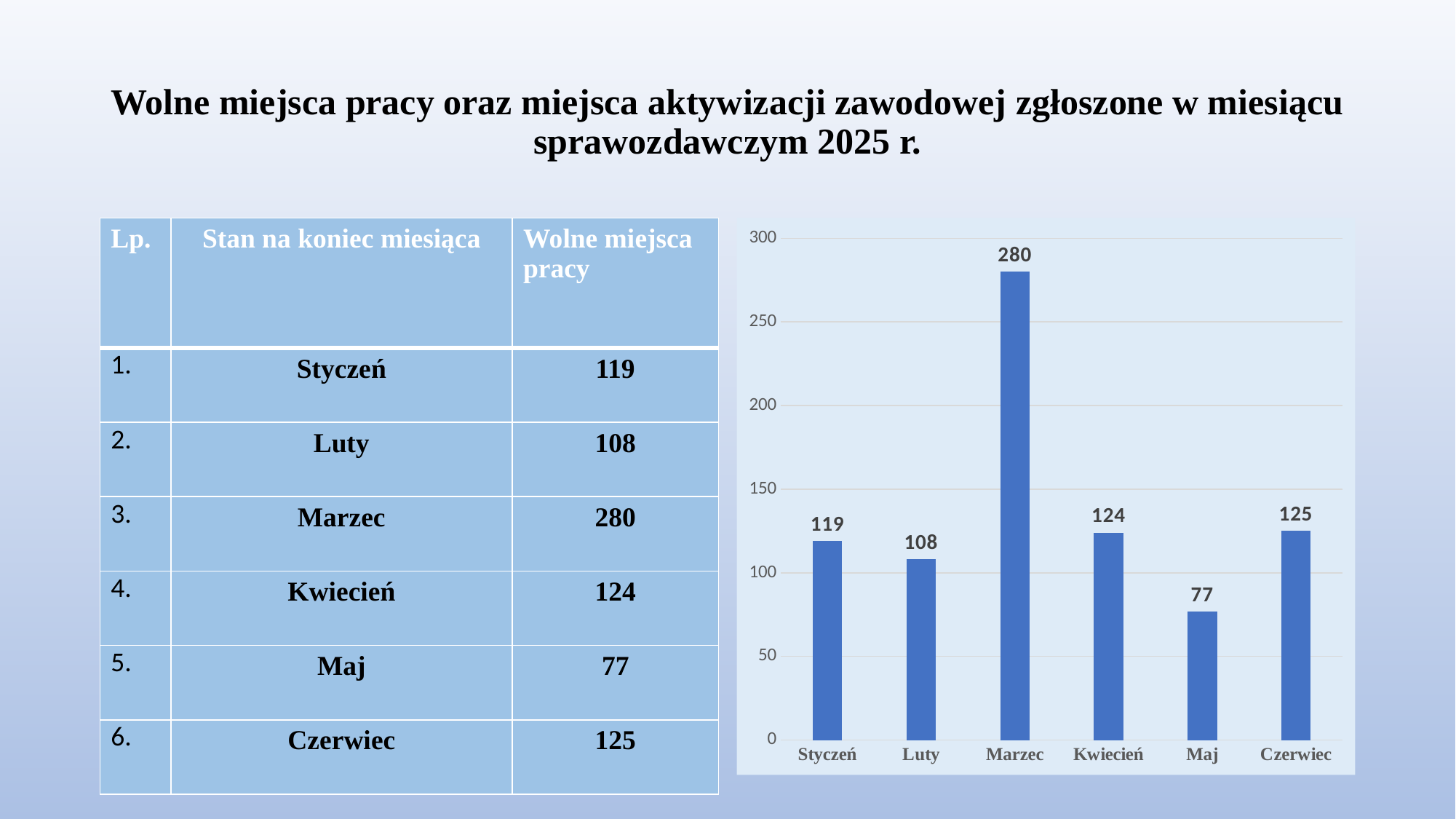
Which month has the lowest value in the bar chart? Maj What is the value for Czerwiec in the bar chart? 125 Is the value for Kwiecień in the bar chart greater or less than 100? greater Which is larger in the bar chart, the value for Styczeń or the value for Luty? Styczeń What is the difference between the values for Czerwiec and Maj in the bar chart? 48 Does the value rise or fall from Kwiecień to Maj in the bar chart? fall What is the value for Maj in the bar chart? 77 What is the difference between the values for Marzec and Luty in the bar chart? 172 How many months are shown on the x axis of the bar chart? 6 What is the value for Marzec in the bar chart? 280 Which month has the highest value in the bar chart? Marzec What kind of chart is shown on the slide? bar chart